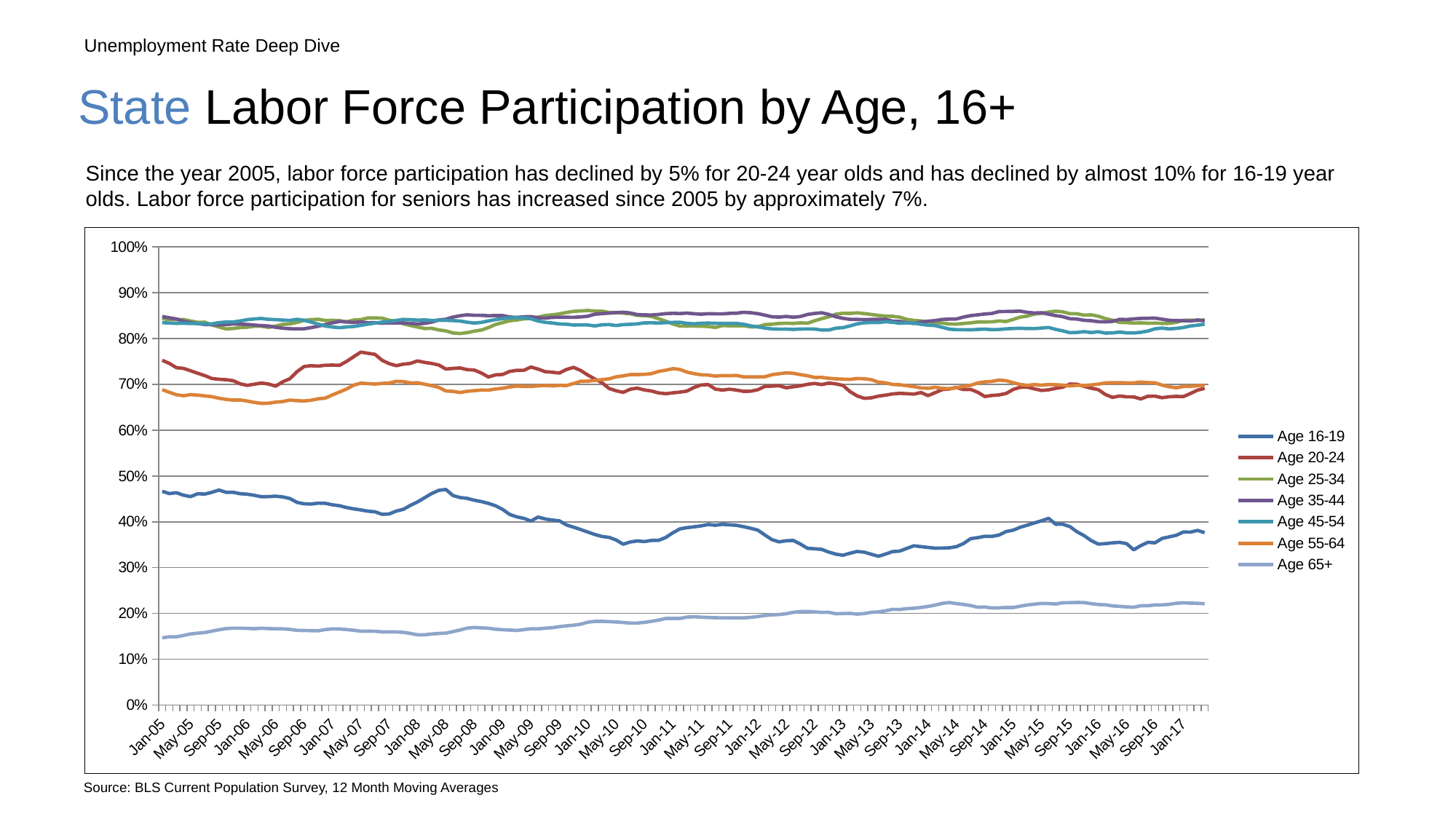
What is the title of the slide containing the chart? State Labor Force Participation by Age, 16+ At Jan-05, which is larger: Age 20-24 or Age 55-64? Age 20-24 Does the Age 65+ line generally rise or fall from Jan-05 to Jan-17? rise Is the value for Age 16-19 at Jan-13 greater or less than 40%? less Is the value for Age 65+ at Jan-05 greater or less than 20%? less Does the Age 16-19 line generally rise or fall from Jan-05 to Jan-17? fall Is the value for Age 65+ at Jan-17 greater or less than 20%? greater What kind of chart is shown on the slide? line chart Which series has the lowest values across the whole chart? Age 65+ How many series does the legend list? 7